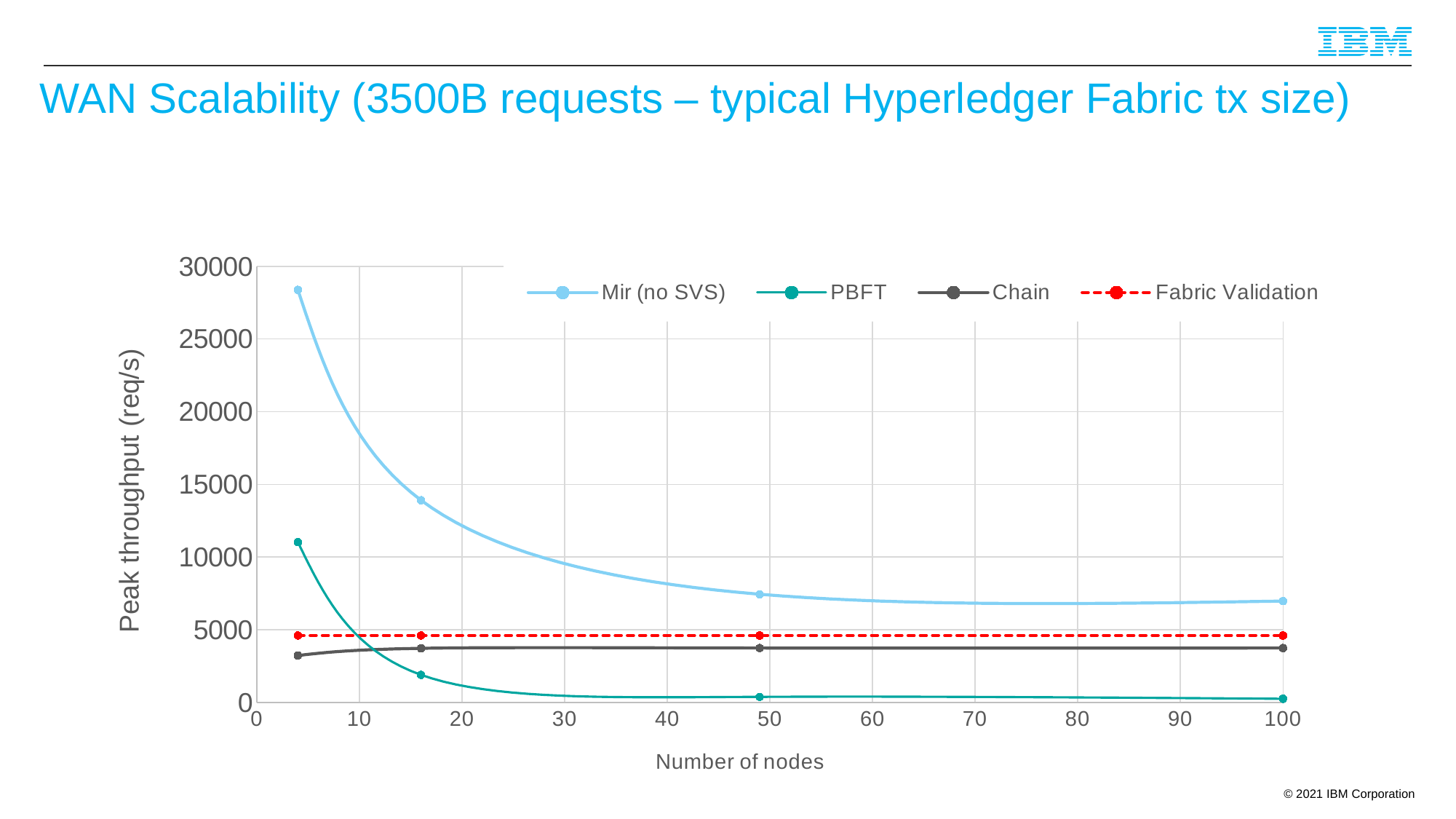
What kind of chart is shown on the slide? line chart At 16 nodes, which is larger: PBFT or Chain? Chain Is the Mir (no SVS) value at 4 nodes greater or less than 25000? greater How many data points are plotted for the Mir (no SVS) series? 4 Which series has the highest throughput at 4 nodes? Mir (no SVS) Is the Fabric Validation value at 49 nodes greater or less than 5000? less Which series has the lowest throughput at 100 nodes? PBFT How many series does the legend list? 4 At 100 nodes, which is larger: Mir (no SVS) or Chain? Mir (no SVS) Is the PBFT value at 4 nodes greater or less than 10000? greater Does the Mir (no SVS) throughput rise or fall as the number of nodes increases? fall Does the PBFT throughput rise or fall as the number of nodes increases? fall